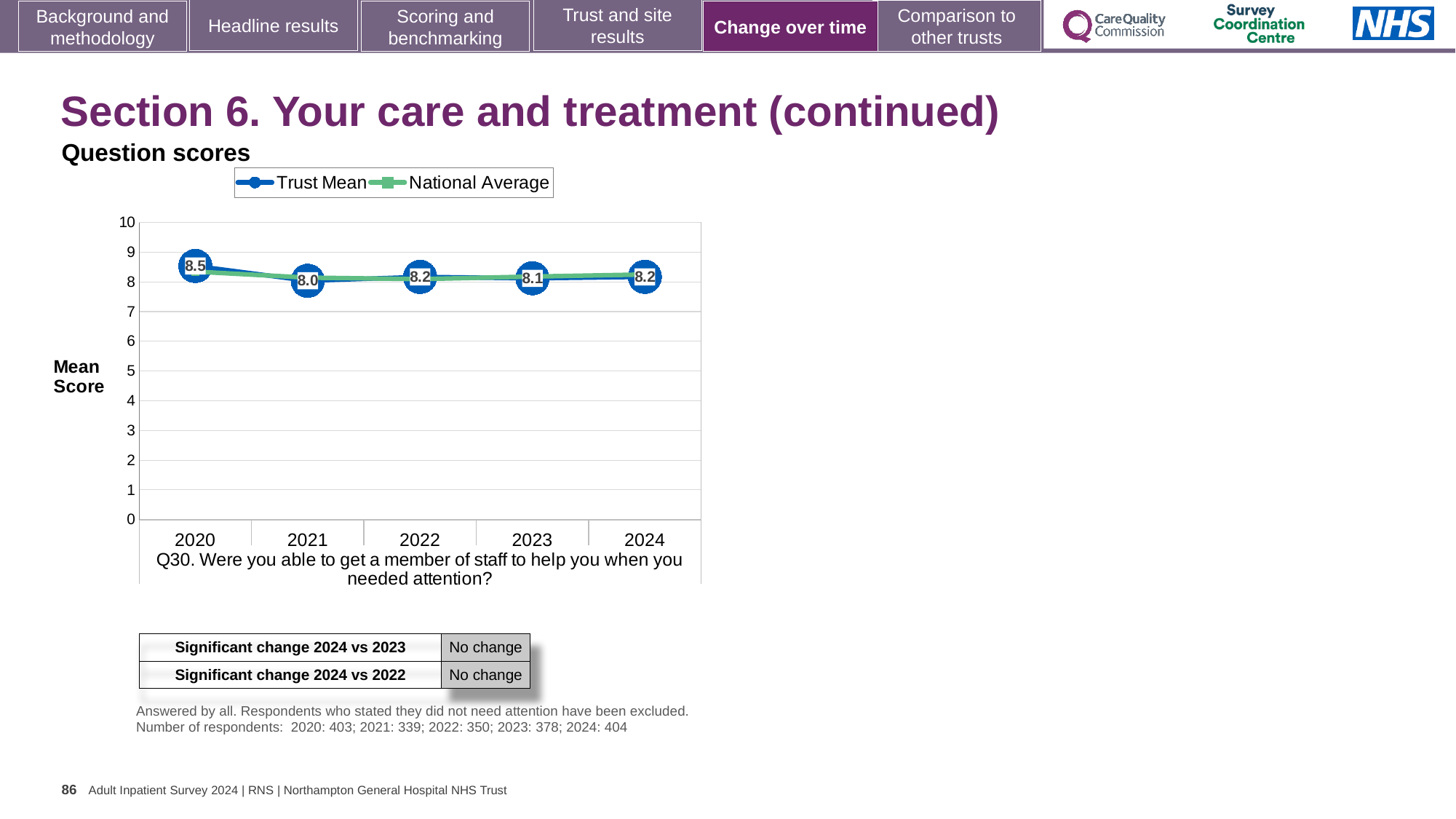
What is the difference between the Trust Mean score in 2020 and in 2021? 0.5 What is the Trust Mean score for 2021? 8.0 Is the National Average value for 2024 greater or less than 5? greater In which year is the Trust Mean score lowest? 2021 Which is larger, the Trust Mean score in 2022 or in 2023? 2022 How many years are plotted on the x axis? 5 How many series does the legend list? 2 Does the Trust Mean score rise or fall from 2020 to 2021? Fall In which year is the Trust Mean score highest? 2020 What is the Trust Mean score for 2020? 8.5 What kind of chart is shown? Line chart What is the Trust Mean score for 2024? 8.2